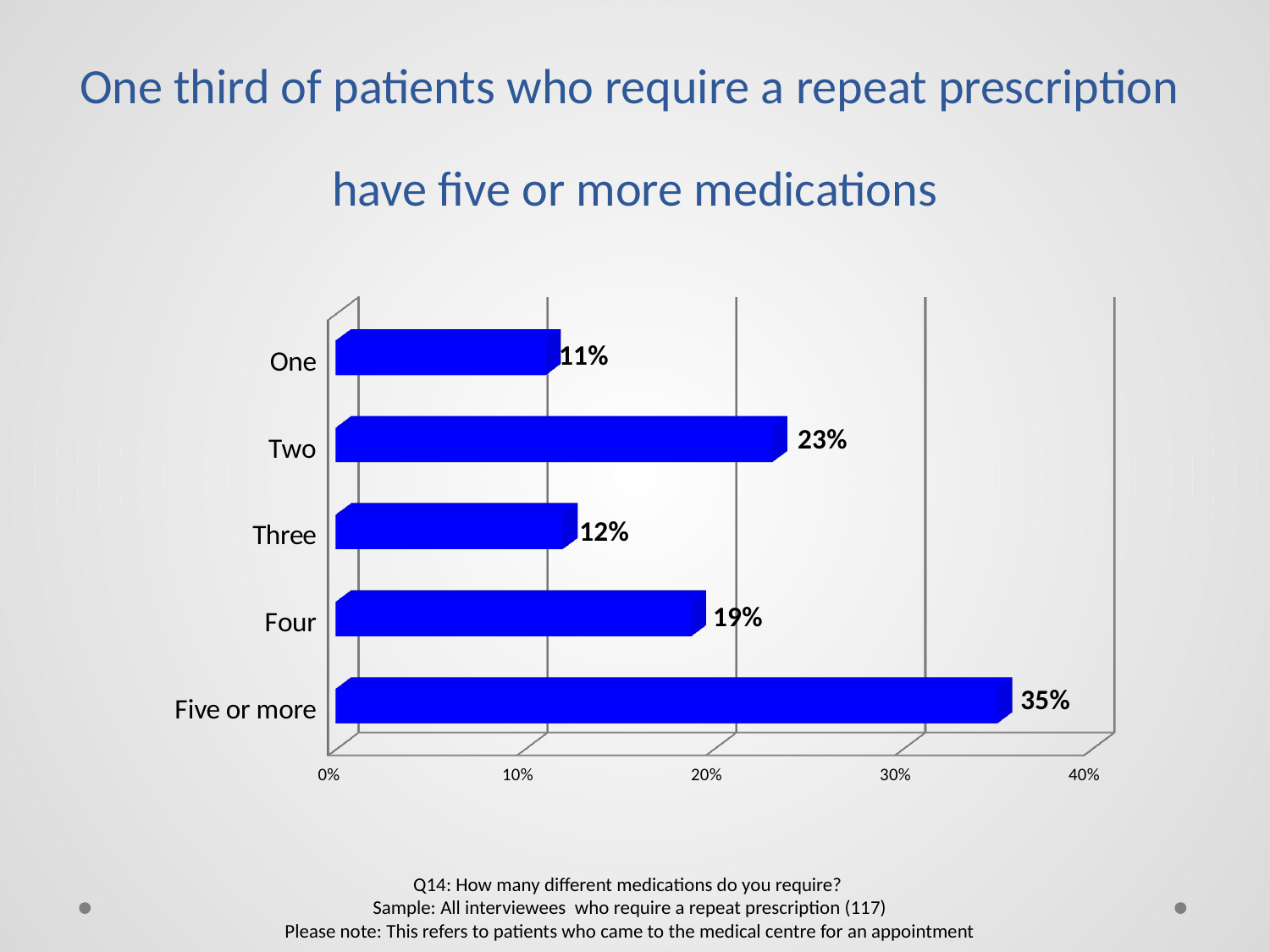
Which category has the lowest value? One What percentage of patients require one medication? 11% What is the difference between the values for 'Four' and 'Three'? 7% What percentage of patients require five or more medications? 35% What is the sample size stated in the footnote of the slide? 117 What kind of chart is shown on the slide? Bar chart How many categories are shown in the chart? 5 Which category has the highest value? Five or more What is the value shown for the 'Two' category? 23% What is the difference between the values for 'Five or more' and 'Two'? 12% Which is larger, the value for 'Two' or the value for 'Four'? Two Is the value for 'Five or more' greater or less than 30%? greater